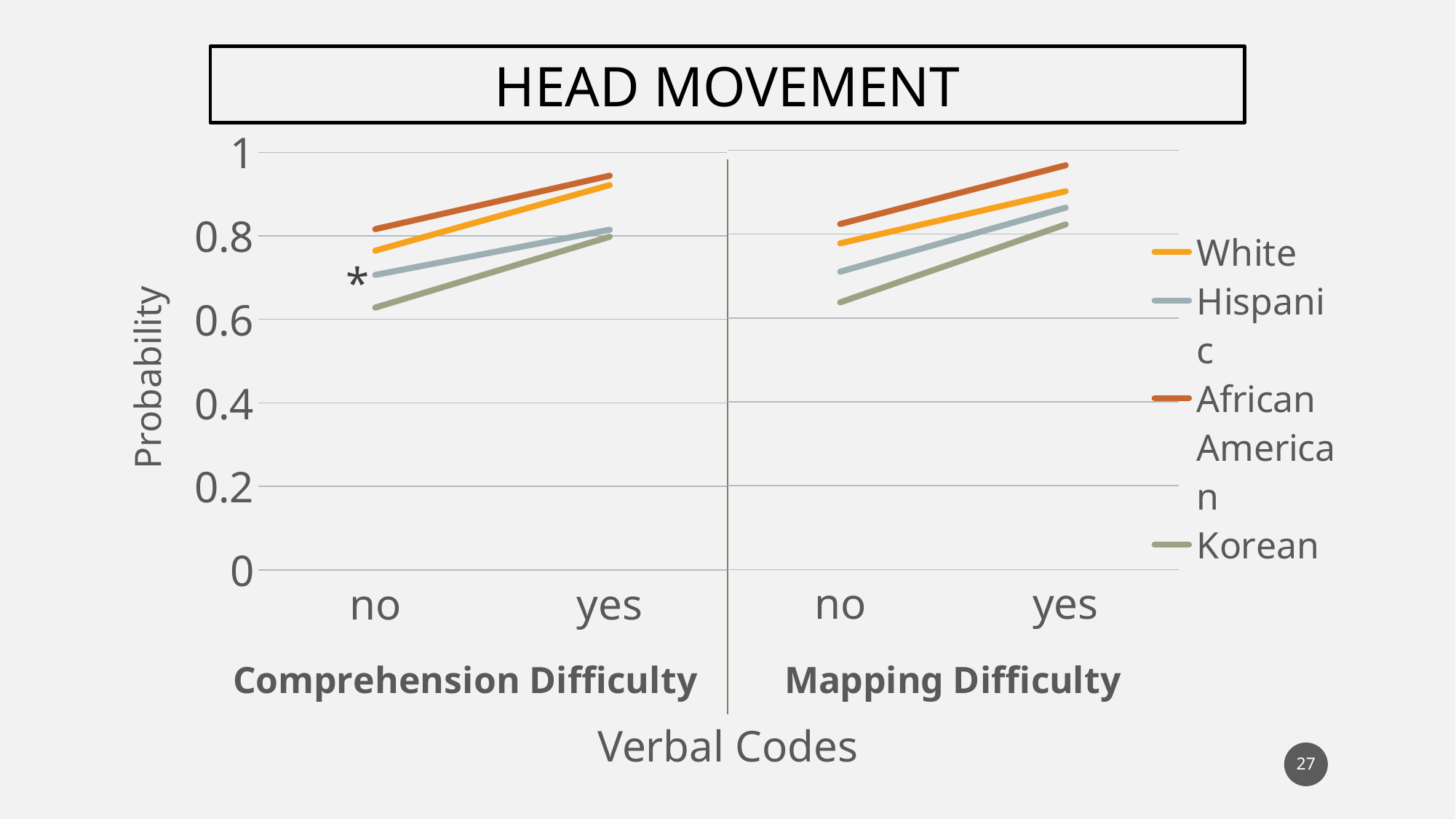
How many series does the legend list? 4 Which series has the highest probability at "yes" under Mapping Difficulty? African American What is the title of the y axis? Probability Which series has the lowest probability at "no" under Mapping Difficulty? Korean Is the value for Korean at "no" under Comprehension Difficulty greater or less than 0.8? less Which series has the highest probability at "no" under Comprehension Difficulty? African American At "no" under Mapping Difficulty, which is larger: the value for White or the value for Hispanic? White Which series has the lowest probability at "no" under Comprehension Difficulty? Korean Is the value for African American at "yes" under Mapping Difficulty greater or less than 0.8? greater Do the lines rise or fall from "no" to "yes" under Comprehension Difficulty? rise What kind of chart is shown on the slide? line chart How many difficulty groups are shown along the x axis? 2